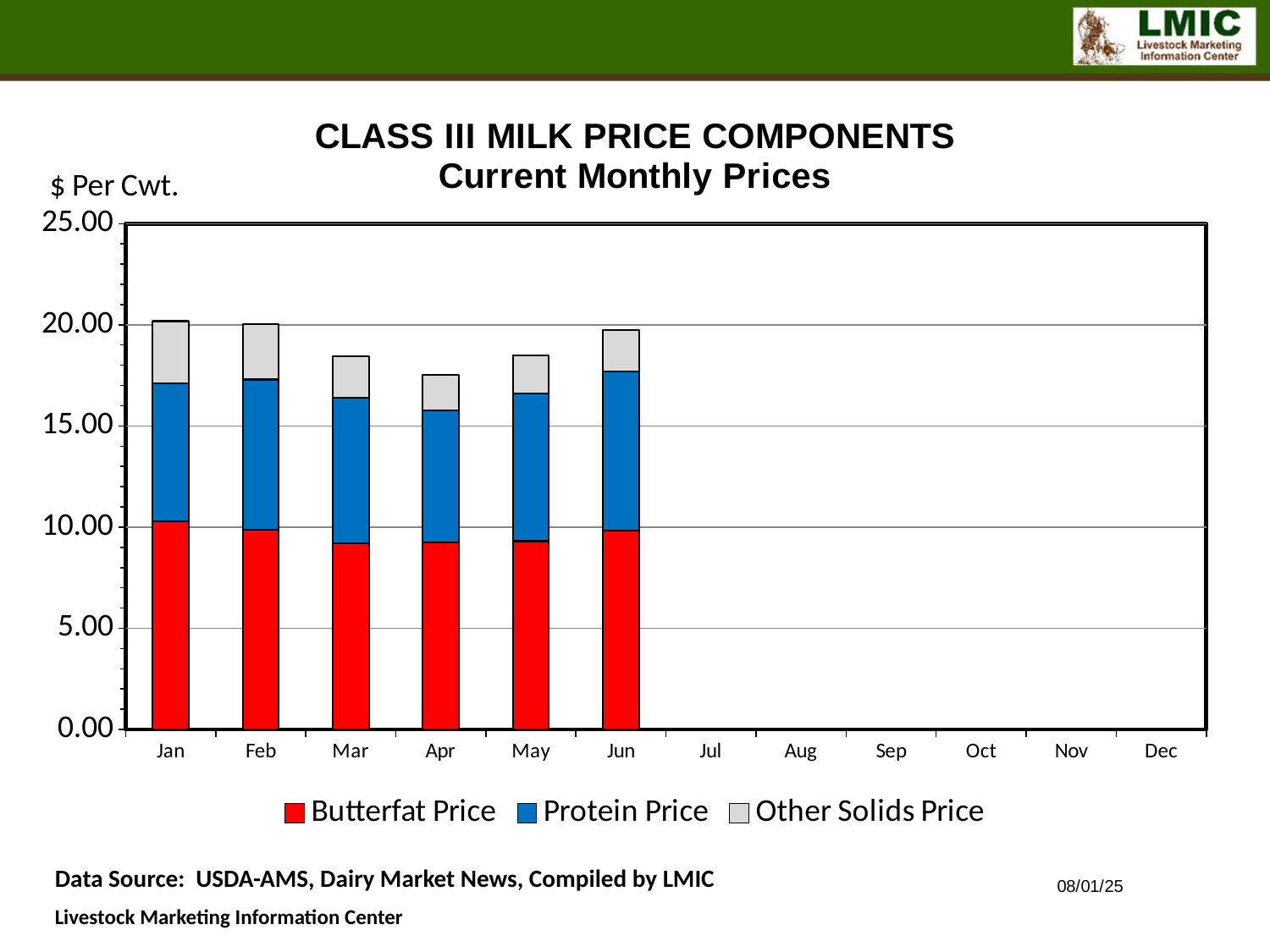
What kind of chart is shown on the slide? Stacked bar chart Is the total stacked value for Jun greater or less than 15.00? greater How many month categories are shown on the x axis? 12 What is the unit label shown on the y axis? $ Per Cwt. Which series is shown in red in the legend? Butterfat Price How many months on the x axis have bars plotted? 6 Is the total stacked value for Apr greater or less than 15.00? greater Is the total stacked value for Apr greater or less than 20.00? less Which is larger, the total stacked value for Jan or for Apr? Jan Which month has the lowest total Class III milk price among the plotted months? Apr How many series does the legend list? 3